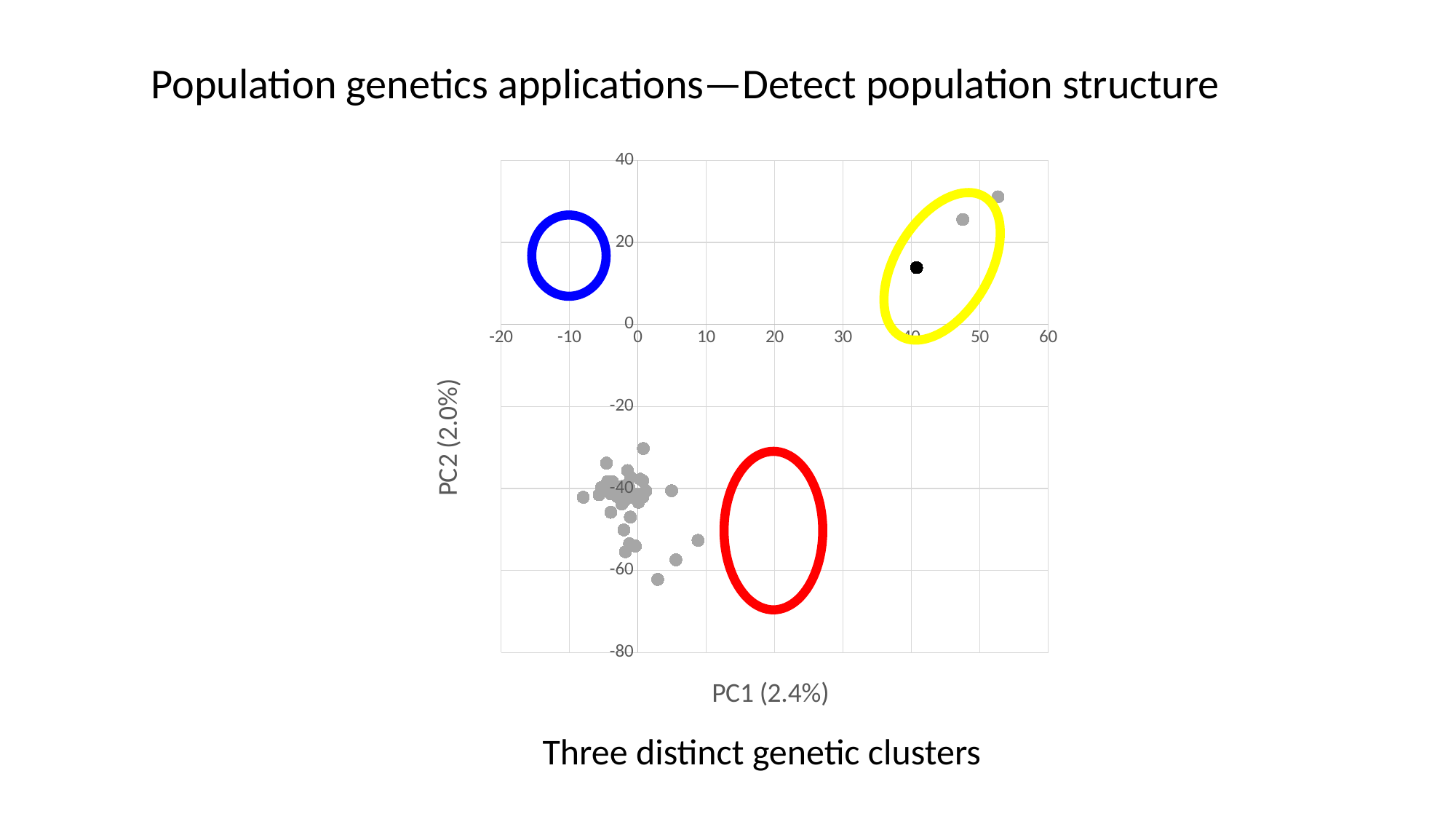
What is the lowest tick value shown on the y axis? -80 Is the PC1 value of the lowest gray point (near PC2 of -60) greater or less than 10? less Is the PC1 value of the black point greater or less than 30? greater What is the label of the x axis of the chart? PC1 (2.4%) Are the PC2 values of the large gray cluster near the bottom left greater or less than -20? less Which has the larger PC2 value: the black point or the points in the large gray cluster at the bottom left? the black point What is the highest tick value shown on the x axis? 60 What kind of chart is shown on the slide? scatter plot What is the label of the y axis of the chart? PC2 (2.0%) How many distinct genetic clusters does the slide say the chart shows? 3